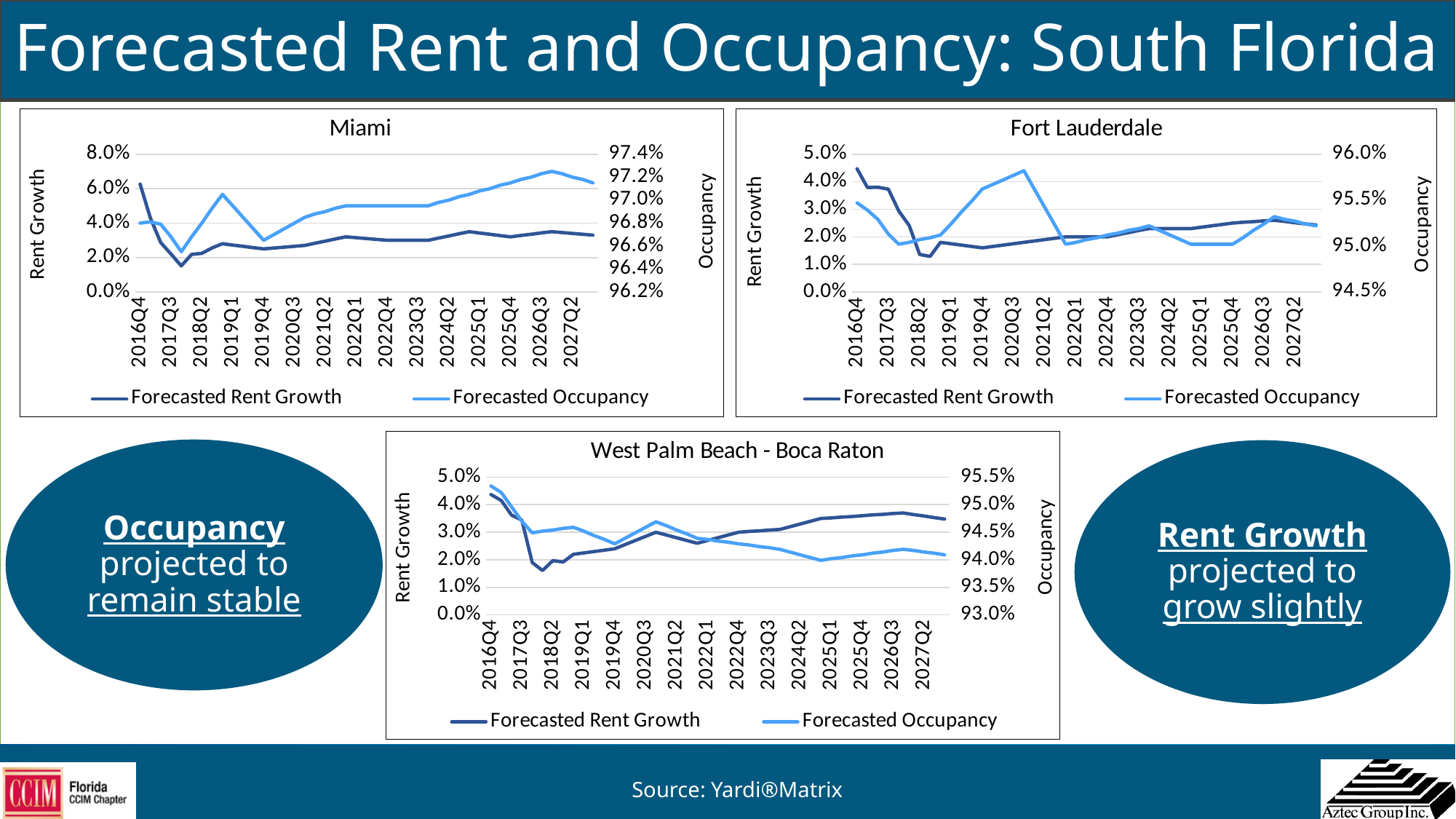
In the Miami chart, is Forecasted Rent Growth larger at 2016Q4 or at 2027Q2? 2016Q4 How many series does the legend of the Fort Lauderdale chart list? 2 In the Miami chart, at which labeled period is Forecasted Rent Growth highest? 2016Q4 In the West Palm Beach - Boca Raton chart, is the Forecasted Occupancy value at 2016Q4 greater or less than 95.0%? greater In the Fort Lauderdale chart, is the Forecasted Occupancy value at 2020Q3 greater or less than 95.5%? greater In the Miami chart, is the Forecasted Rent Growth value at 2016Q4 greater or less than 4.0%? greater In the Fort Lauderdale chart, does Forecasted Rent Growth rise or fall between 2016Q4 and 2018Q2? fall What kind of chart is the Miami chart? line chart In the Miami chart, does Forecasted Occupancy rise or fall between 2019Q4 and 2026Q3? rise In the West Palm Beach - Boca Raton chart, what are the two series named in the legend? Forecasted Rent Growth and Forecasted Occupancy In the Fort Lauderdale chart, at which labeled period is Forecasted Occupancy highest? 2020Q3